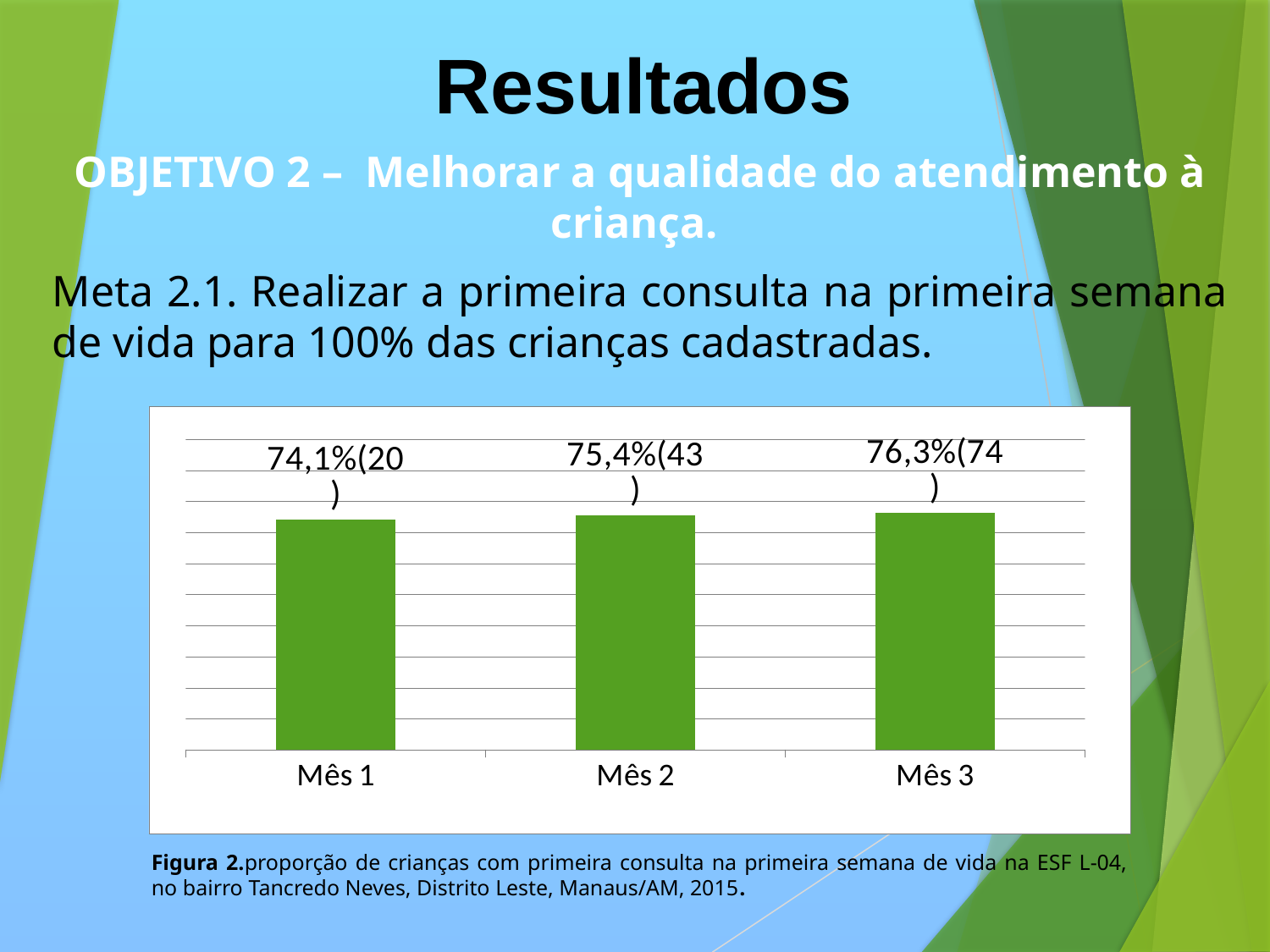
How many months are shown on the x axis? 3 What percentage is shown for Mês 3? 76,3% What is the data label shown for Mês 3? 76,3%(74) Which month has the highest percentage? Mês 3 Which month has the lowest percentage? Mês 1 What is the data label shown for Mês 1? 74,1%(20) What is the difference in percentage points between Mês 3 and Mês 1? 2,2 Do the percentages rise or fall from Mês 1 to Mês 3? Rise What kind of chart is shown on the slide? Bar chart What number appears in parentheses in the data label for Mês 2? 43 What is the data label shown for Mês 2? 75,4%(43) Which is larger, the percentage for Mês 1 or for Mês 2? Mês 2